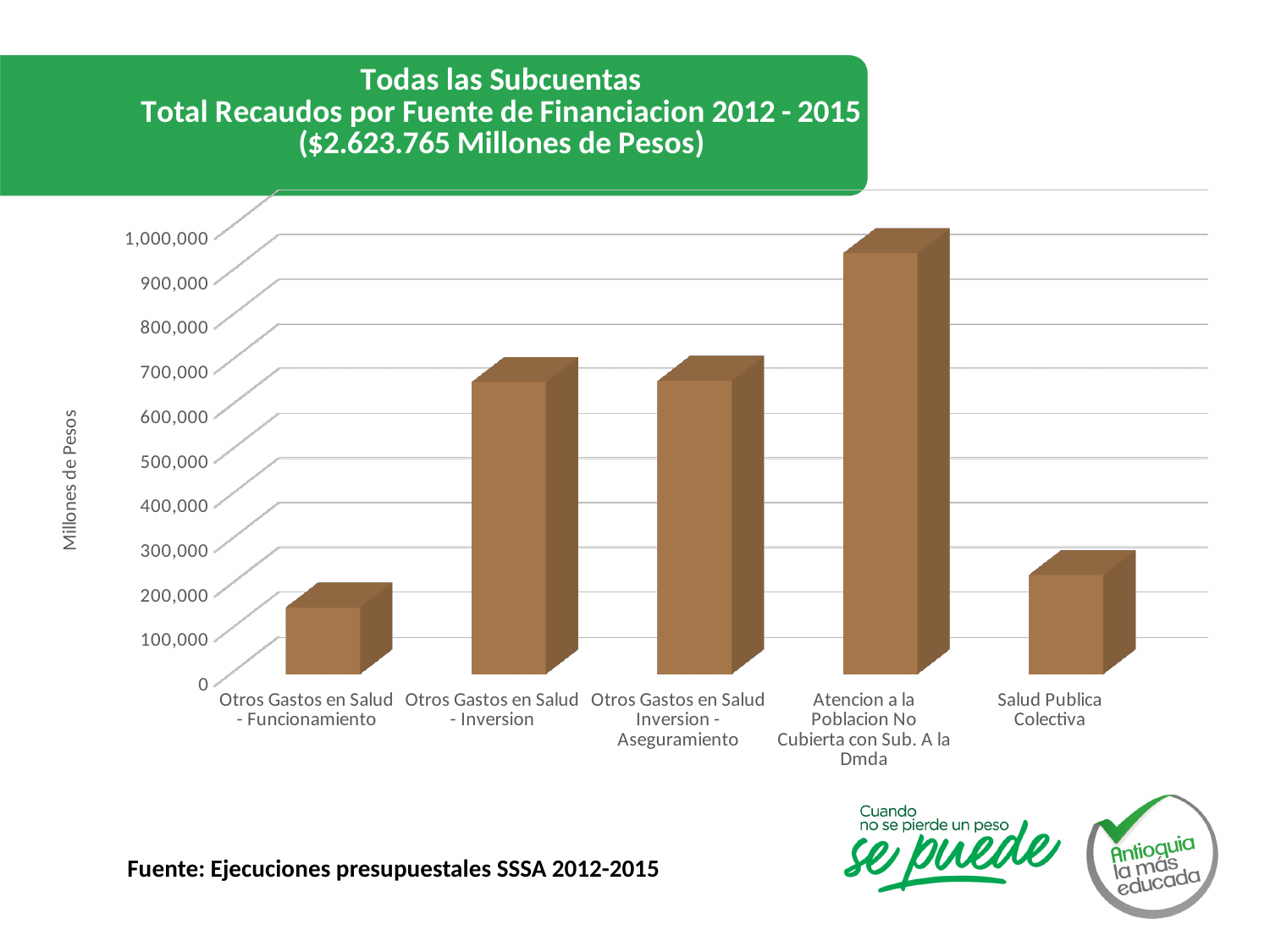
Which category has the lowest value? Otros Gastos en Salud - Funcionamiento What is the label of the vertical axis? Millones de Pesos How many categories are plotted on the x axis? 5 What kind of chart is shown on the slide? Bar chart Which is larger, the value for Atencion a la Poblacion No Cubierta con Sub. A la Dmda or the value for Otros Gastos en Salud - Inversion? Atencion a la Poblacion No Cubierta con Sub. A la Dmda Is the value for Otros Gastos en Salud - Inversion greater or less than 600,000? greater Is the value for Otros Gastos en Salud - Funcionamiento greater or less than 200,000? less Which category has the highest value? Atencion a la Poblacion No Cubierta con Sub. A la Dmda What total amount is given in parentheses in the chart title? $2.623.765 Millones de Pesos Is the value for Atencion a la Poblacion No Cubierta con Sub. A la Dmda greater or less than 900,000? greater Which is larger, the value for Salud Publica Colectiva or the value for Otros Gastos en Salud - Funcionamiento? Salud Publica Colectiva